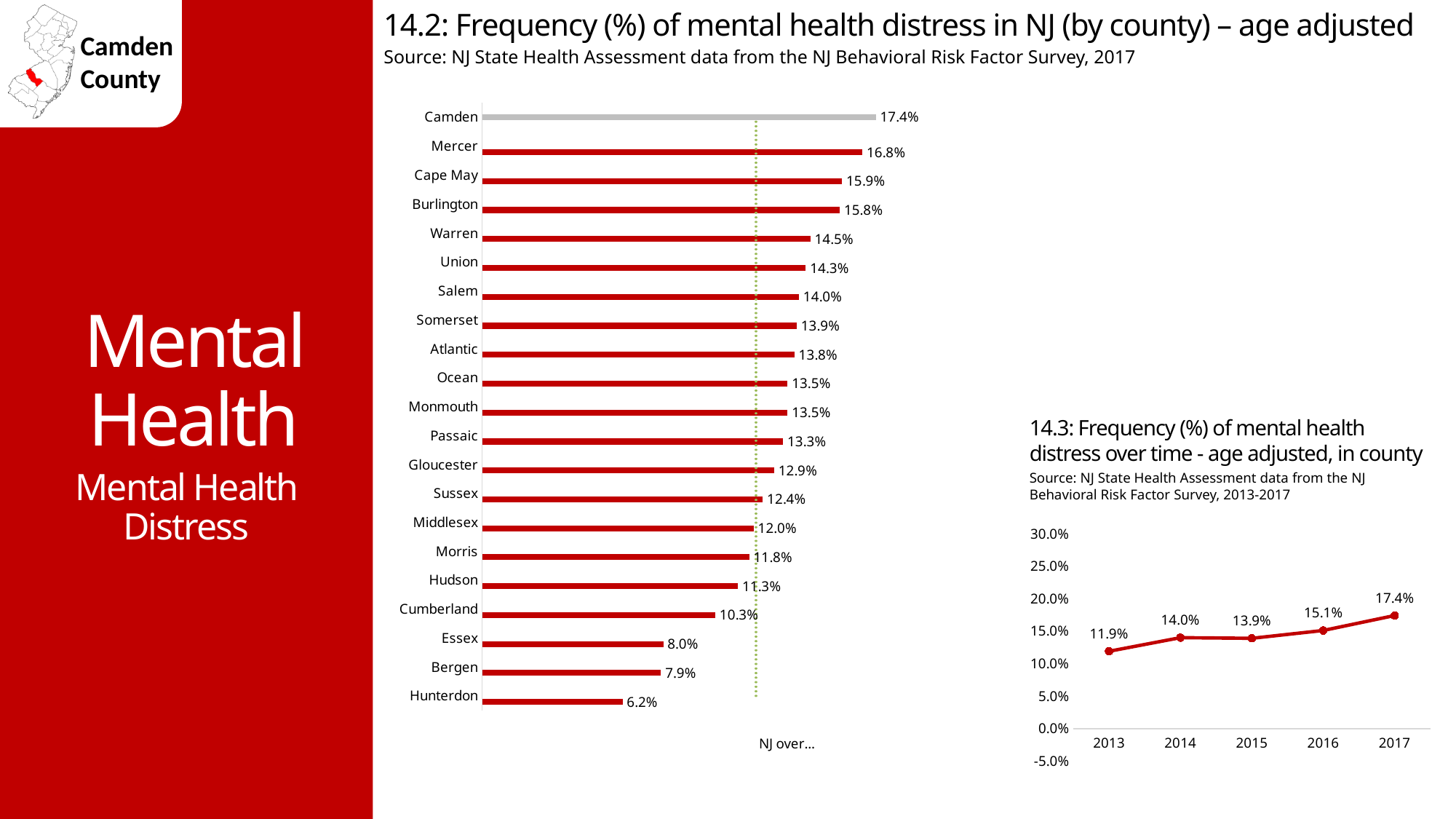
In chart 14.3 (mental health distress over time), what is the value for 2013? 11.9% In chart 14.2 (mental health distress by county), what is the value for Gloucester? 12.9% What kind of chart is chart 14.2 (mental health distress by county)? Bar chart In chart 14.2 (mental health distress by county), which county has the highest value? Camden In chart 14.2 (mental health distress by county), what is the difference between Camden and Hunterdon? 11.2% In chart 14.2 (mental health distress by county), which is larger, the value for Essex or the value for Bergen? Essex In chart 14.2 (mental health distress by county), how many counties are shown? 21 In chart 14.3 (mental health distress over time), what is the difference between the 2017 and 2016 values? 2.3% In chart 14.2 (mental health distress by county), which county has the lowest value? Hunterdon In chart 14.2 (mental health distress by county), what is the value for Camden? 17.4% In chart 14.3 (mental health distress over time), how many years are plotted? 5 In chart 14.3 (mental health distress over time), do the values generally rise or fall from 2013 to 2017? Rise